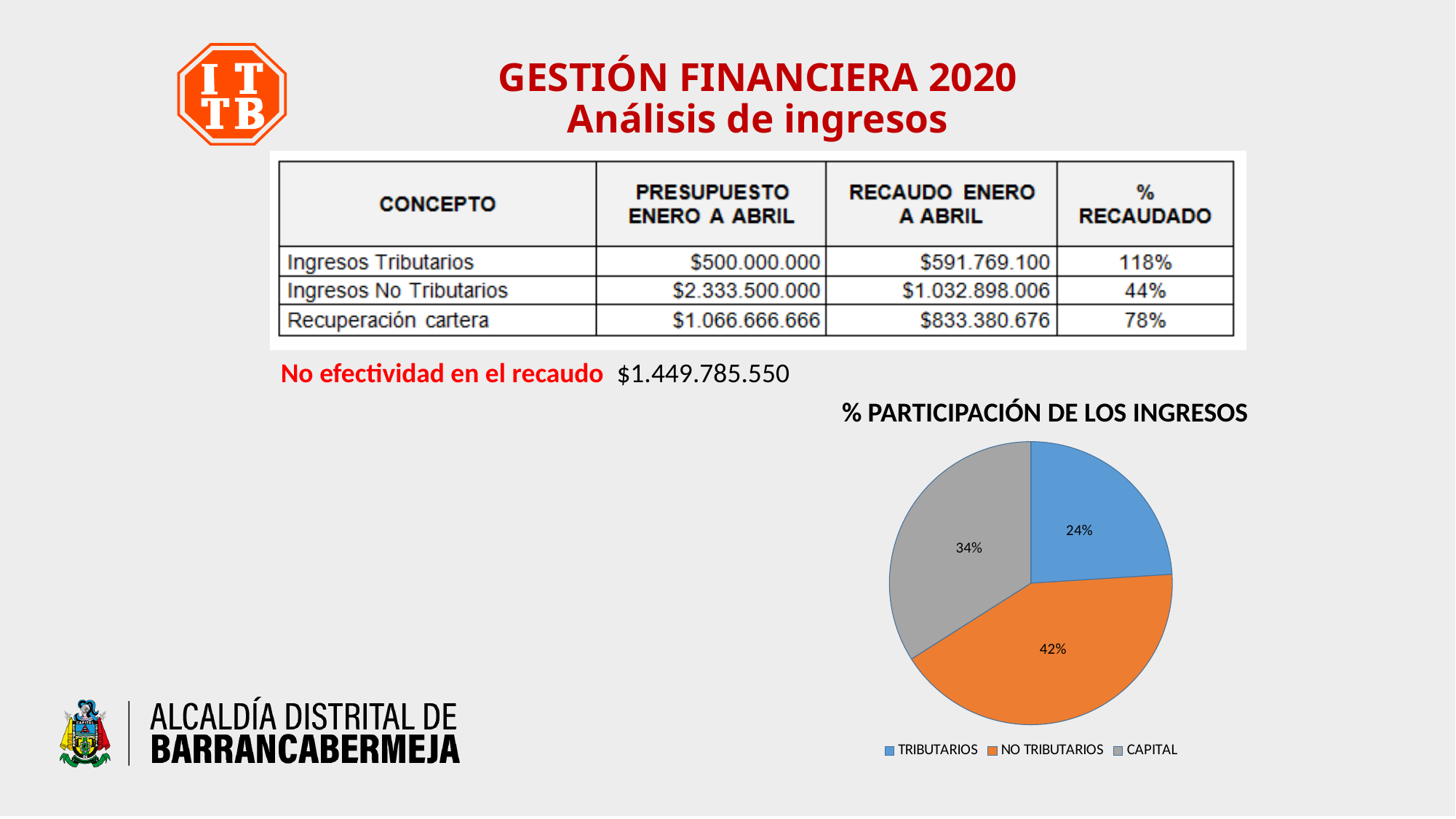
What is the difference in percentage points between the CAPITAL slice and the TRIBUTARIOS slice? 10% What share of the pie does TRIBUTARIOS represent? 24% What share of the pie does CAPITAL represent? 34% What type of chart is shown on the slide? Pie chart Which category has the smallest slice of the pie? TRIBUTARIOS Which slice is larger, CAPITAL or TRIBUTARIOS? CAPITAL What is the title of the chart? % PARTICIPACIÓN DE LOS INGRESOS How many slices does the pie chart have? 3 What colour is the NO TRIBUTARIOS slice? Orange Which category has the largest slice of the pie? NO TRIBUTARIOS What share of the pie does NO TRIBUTARIOS represent? 42% What is the difference in percentage points between the NO TRIBUTARIOS slice and the TRIBUTARIOS slice? 18%